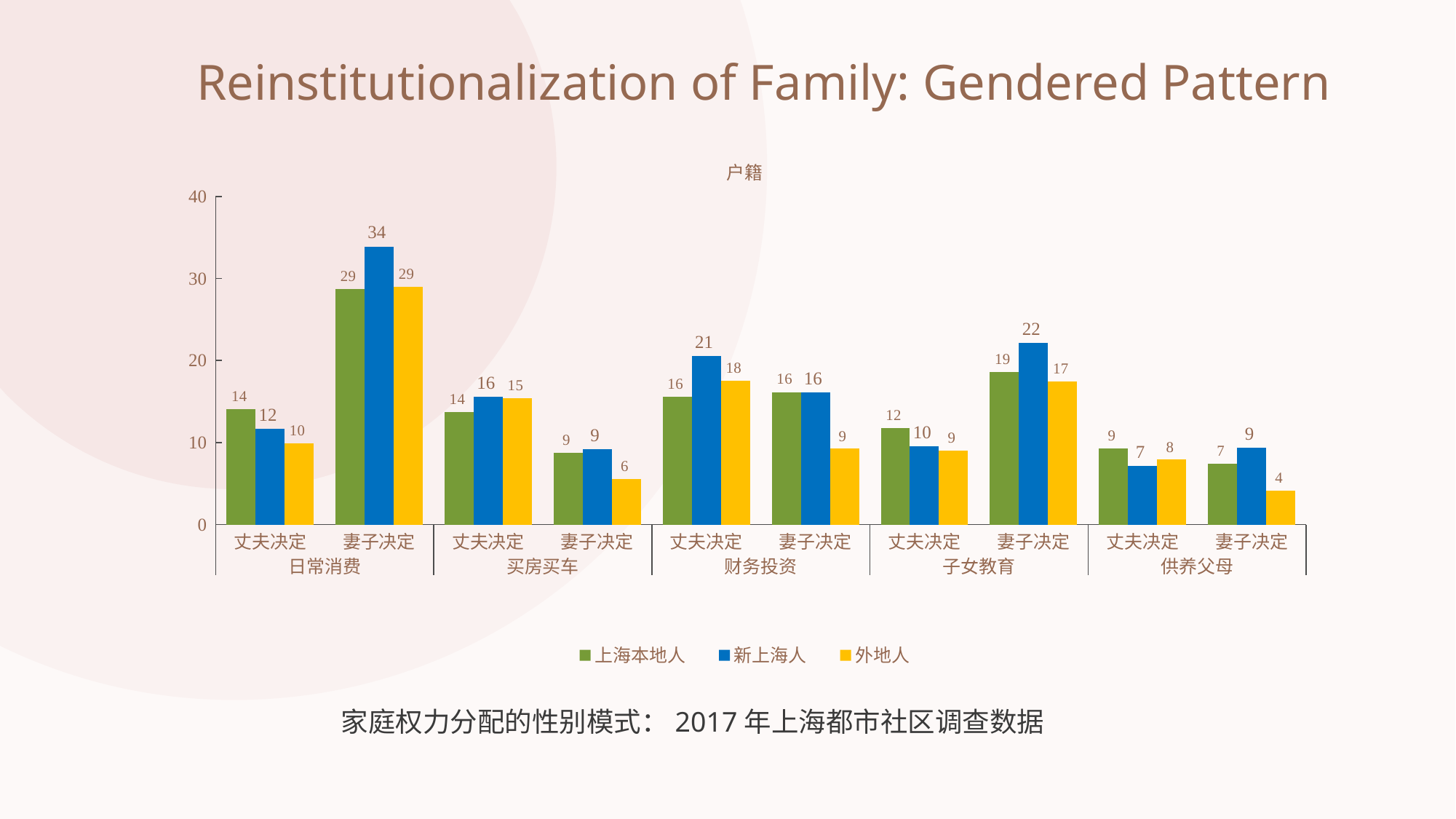
Which series has the highest value under 财务投资 丈夫决定? 新上海人 Is the 新上海人 value under 日常消费 妻子决定 greater or less than 30? greater How many top-level categories are shown along the x axis? 5 What is the value for 上海本地人 under 子女教育 妻子决定? 19 What type of chart is shown on the slide? bar chart What is the value for 外地人 under 供养父母 妻子决定? 4 What is the value for 新上海人 under 日常消费 妻子决定? 34 What is the difference between the 新上海人 and 外地人 values under 子女教育 妻子决定? 5 Which is larger: the 上海本地人 value under 日常消费 丈夫决定 or the 外地人 value under 日常消费 丈夫决定? 上海本地人 What is the title of the chart? 户籍 How many series does the legend list? 3 Which series has the lowest value under 买房买车 妻子决定? 外地人